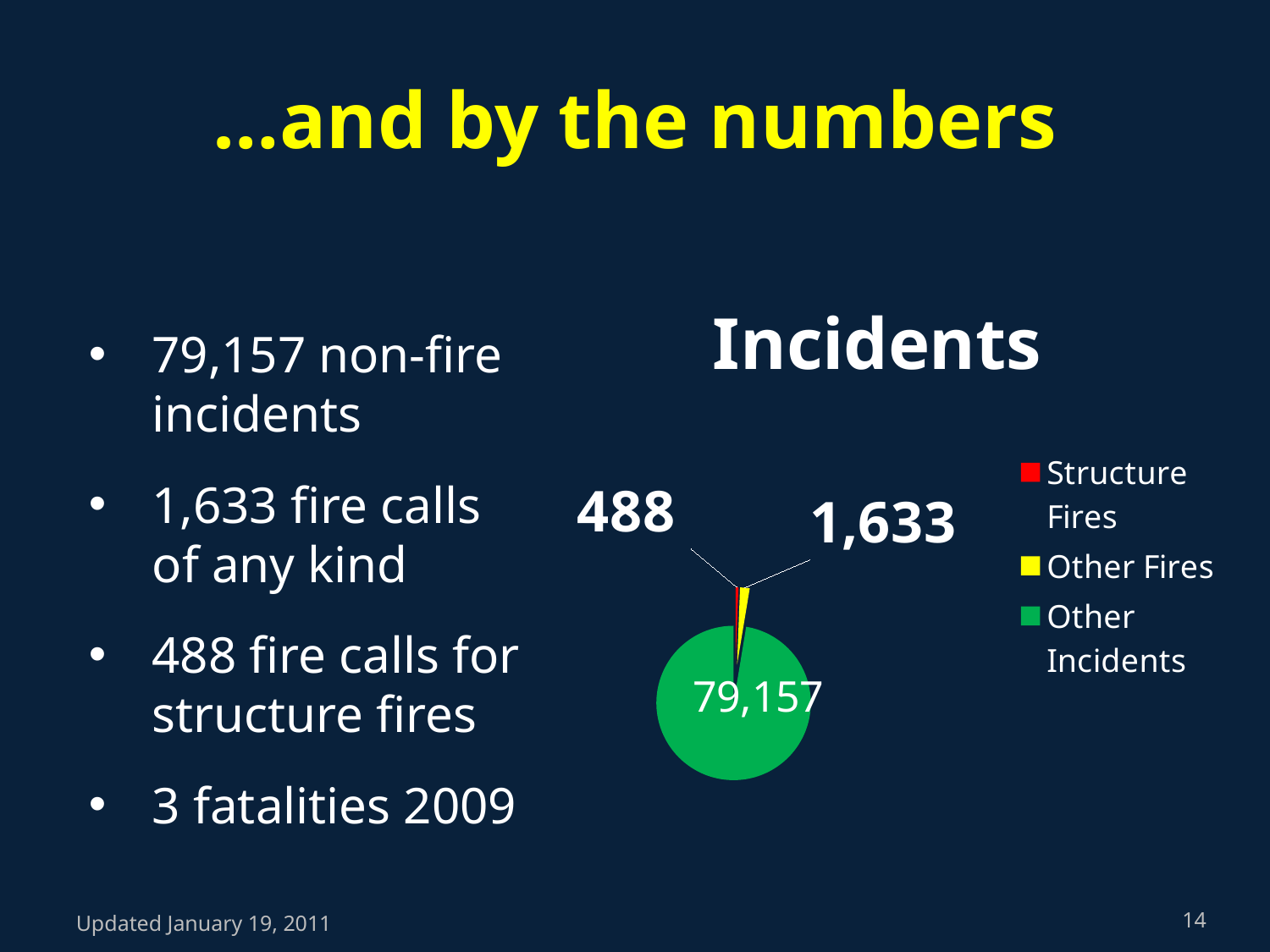
What is the value for Other Incidents in the Incidents chart? 79,157 What type of chart is shown on the slide? pie chart What colour represents Other Incidents in the Incidents chart? green How many entries does the legend of the Incidents chart list? 3 What is the value for Other Fires in the Incidents chart? 1,633 Which category has the smallest slice in the Incidents chart? Structure Fires What is the value for Structure Fires in the Incidents chart? 488 What is the title of the chart? Incidents Which is larger in the Incidents chart, Other Fires or Structure Fires? Other Fires Which category has the largest slice in the Incidents chart? Other Incidents How many slices does the Incidents pie chart have? 3 What is the difference between Other Fires and Structure Fires in the Incidents chart? 1,145